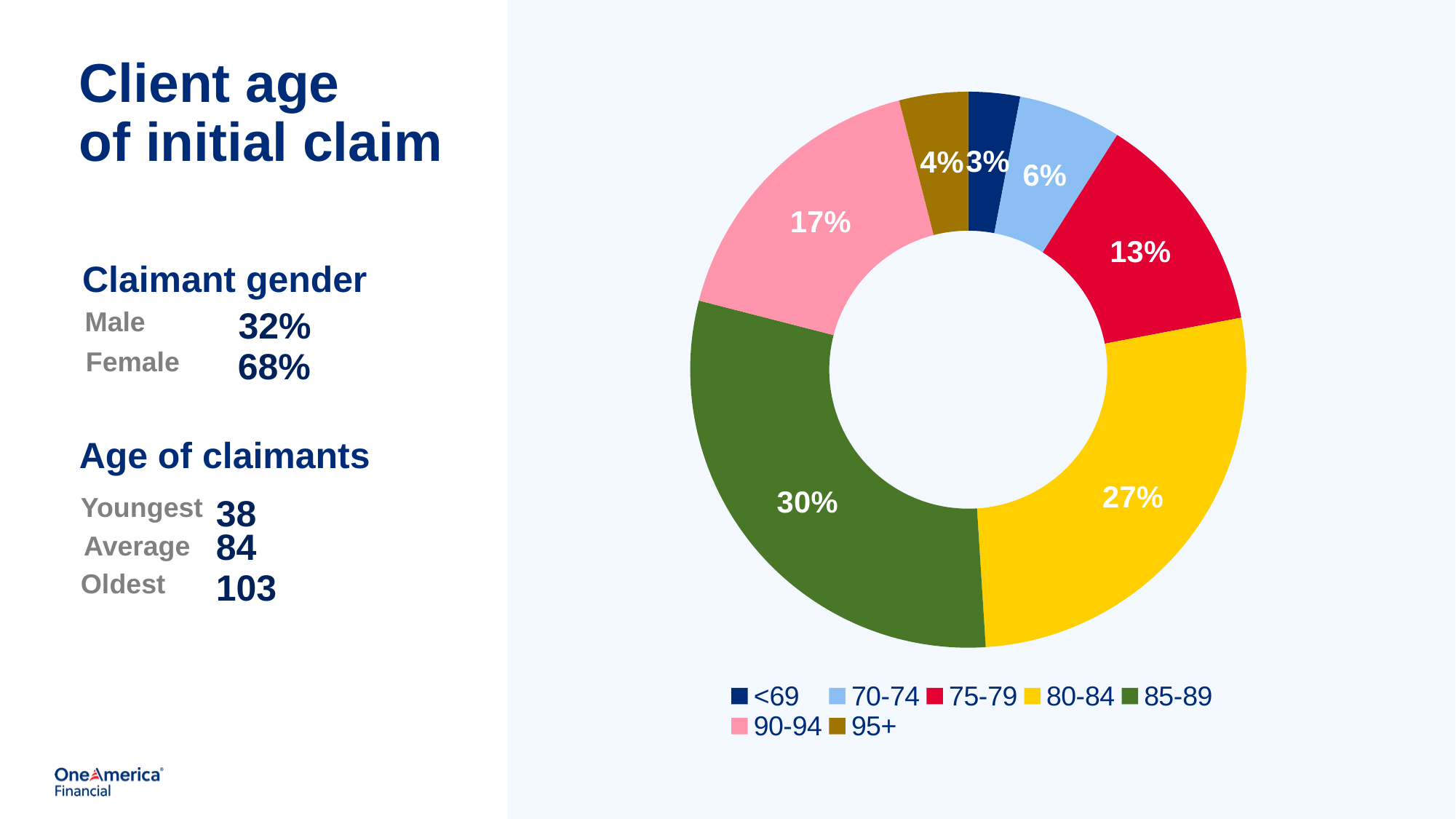
What share of initial claims is for clients aged 85-89? 30% What share of initial claims is for clients aged 80-84? 27% How many age groups are shown in the chart? 7 What type of chart is used to show client age of initial claim? Doughnut chart What is the difference in percentage points between the 85-89 and 80-84 age groups? 3 What share of initial claims is for clients aged 90-94? 17% What share of initial claims is for clients aged 95+? 4% Which age group has a larger share: 70-74 or 75-79? 75-79 Which age group has the largest share of initial claims? 85-89 What colour represents the 80-84 age group in the chart? Yellow Which age group has the smallest share of initial claims? <69 What share of initial claims is for clients aged 75-79? 13%